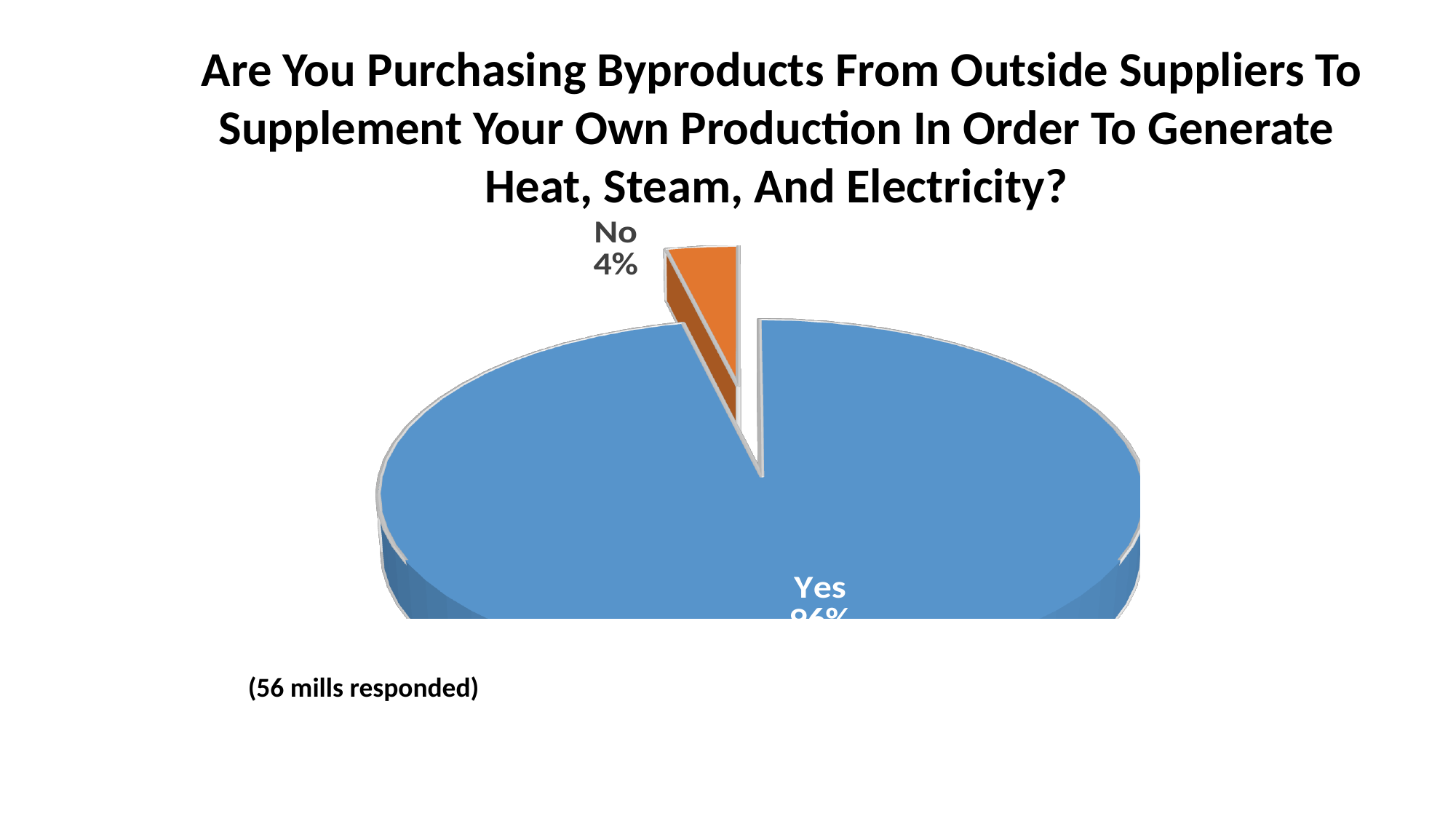
What is the difference in percentage points between the "Yes" and "No" shares? 92 percentage points What percentage of respondents answered "Yes"? 96% Which is larger, the share for "Yes" or the share for "No"? Yes What colour is the "No" slice of the pie chart? orange What percentage of respondents answered "No"? 4% How many slices does the pie chart have? 2 Which response has the largest share of the pie? Yes What kind of chart is shown on the slide? pie chart How many mills responded to the survey question shown on the slide? 56 What share of the pie does the "No" slice represent? 4% Which response has the smallest share of the pie? No